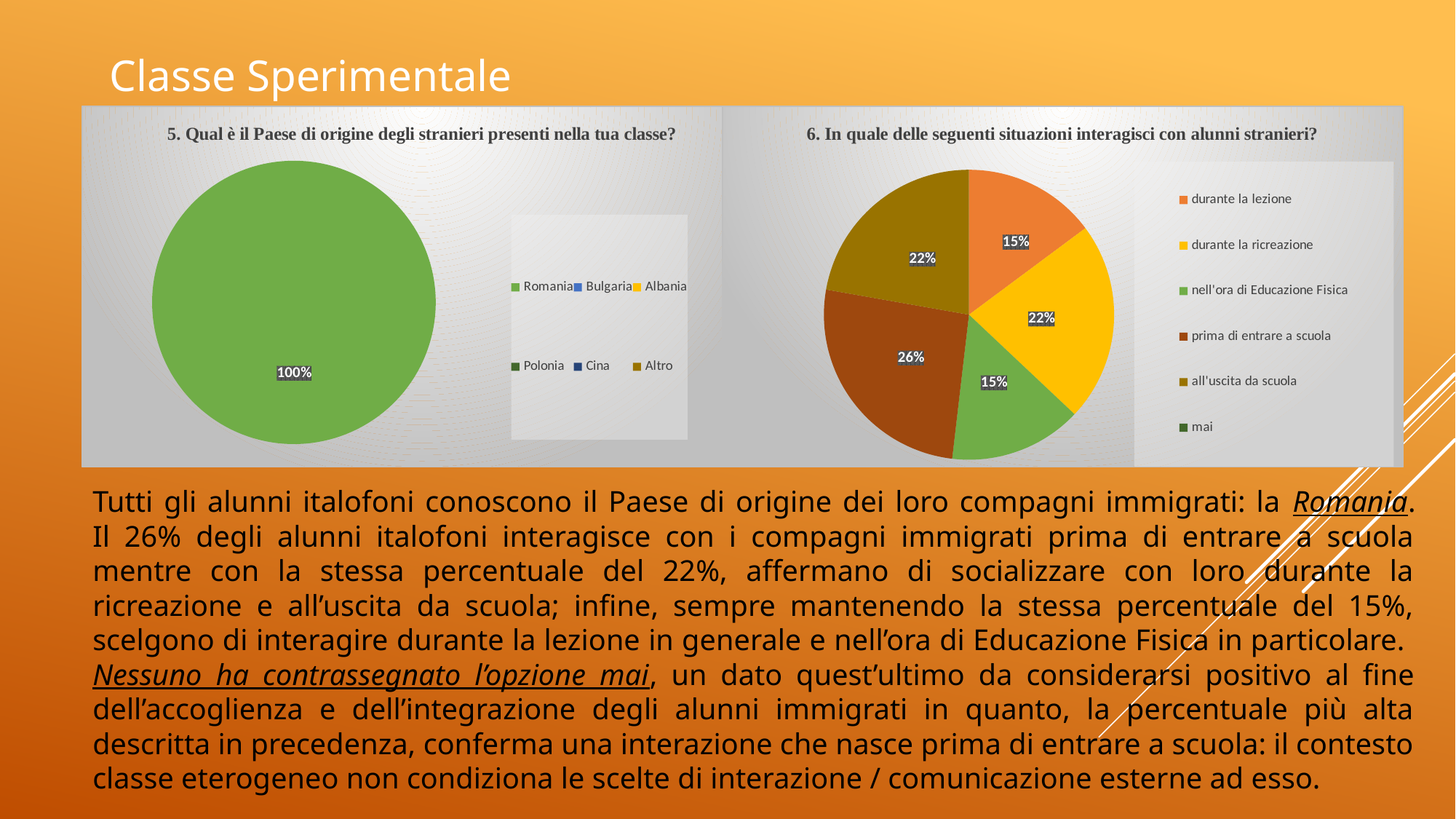
In the chart titled "6. In quale delle seguenti situazioni interagisci con alunni stranieri?", what is the value for "durante la ricreazione"? 22% In the chart titled "6. In quale delle seguenti situazioni interagisci con alunni stranieri?", which is larger: "all'uscita da scuola" or "durante la lezione"? all'uscita da scuola In the chart titled "6. In quale delle seguenti situazioni interagisci con alunni stranieri?", how many slices are visible in the pie? 5 How many entries does the legend of the chart titled "5. Qual è il Paese di origine degli stranieri presenti nella tua classe?" list? 6 In the chart titled "5. Qual è il Paese di origine degli stranieri presenti nella tua classe?", what share does Romania have? 100% In the chart titled "6. In quale delle seguenti situazioni interagisci con alunni stranieri?", which situation has the largest share? prima di entrare a scuola In the chart titled "6. In quale delle seguenti situazioni interagisci con alunni stranieri?", what is the difference between the shares for "prima di entrare a scuola" and "nell'ora di Educazione Fisica"? 11% In the chart titled "6. In quale delle seguenti situazioni interagisci con alunni stranieri?", what is the value for "durante la lezione"? 15% What kind of chart is the chart titled "5. Qual è il Paese di origine degli stranieri presenti nella tua classe?"? Pie chart In the chart titled "6. In quale delle seguenti situazioni interagisci con alunni stranieri?", what is the value for "prima di entrare a scuola"? 26% How many entries does the legend of the chart titled "6. In quale delle seguenti situazioni interagisci con alunni stranieri?" list? 6 In the chart titled "6. In quale delle seguenti situazioni interagisci con alunni stranieri?", which legend entry is shown in yellow? durante la ricreazione